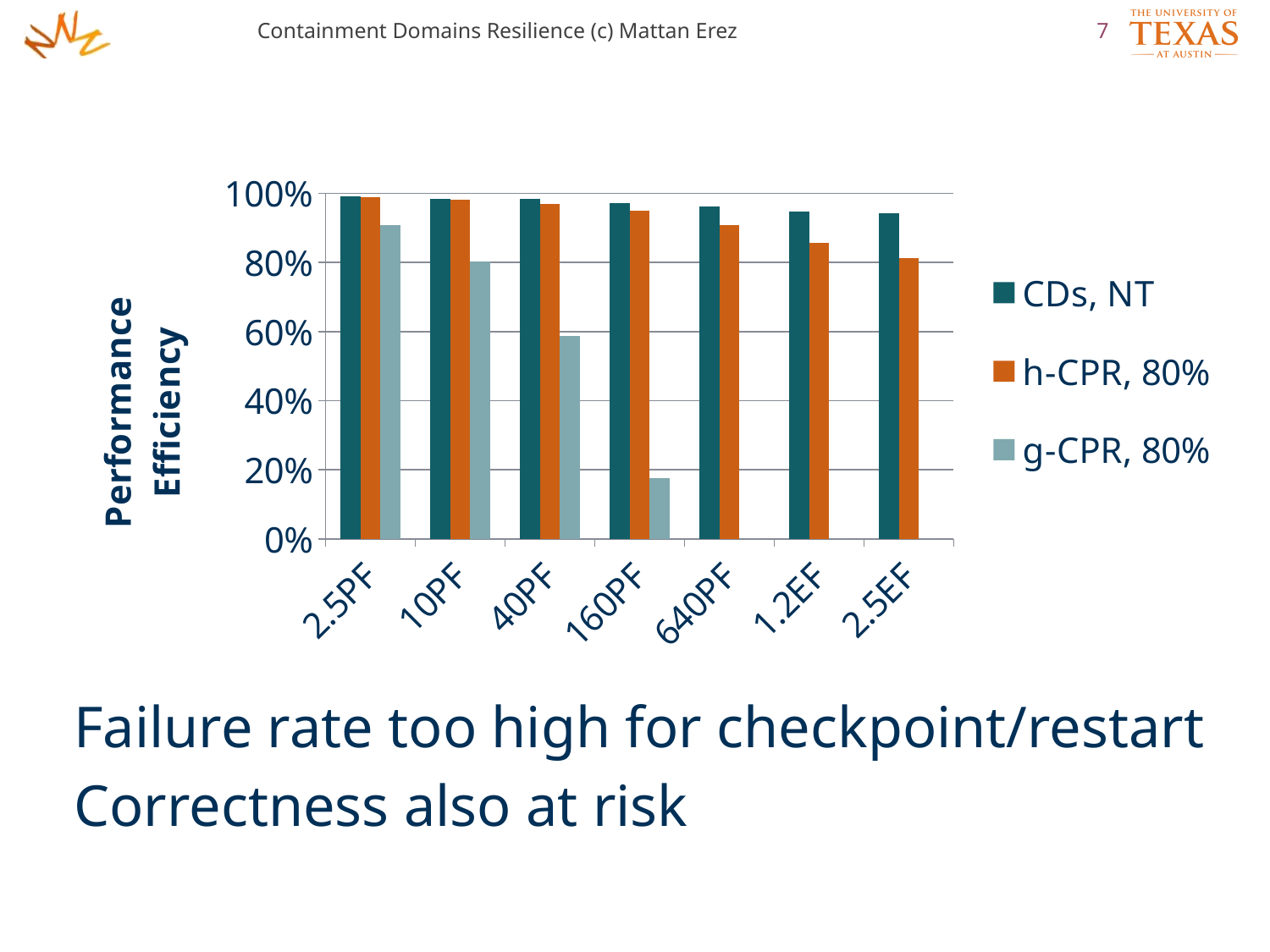
Is the value for g-CPR, 80% at 2.5PF greater or less than 80%? greater At 2.5EF, which is larger: CDs, NT or h-CPR, 80%? CDs, NT How many series does the chart's legend list? 3 For which category is the g-CPR, 80% value highest? 2.5PF Is the value for g-CPR, 80% at 160PF greater or less than 20%? less What kind of chart is shown on the slide? bar chart Is the value for g-CPR, 80% at 40PF greater or less than 40%? greater What is the label of the vertical axis of the chart? Performance Efficiency Do the g-CPR, 80% values rise or fall as you move from 2.5PF to 160PF along the x axis? fall How many categories are shown on the x axis of the chart? 7 Which series is shown in orange in the chart? h-CPR, 80%